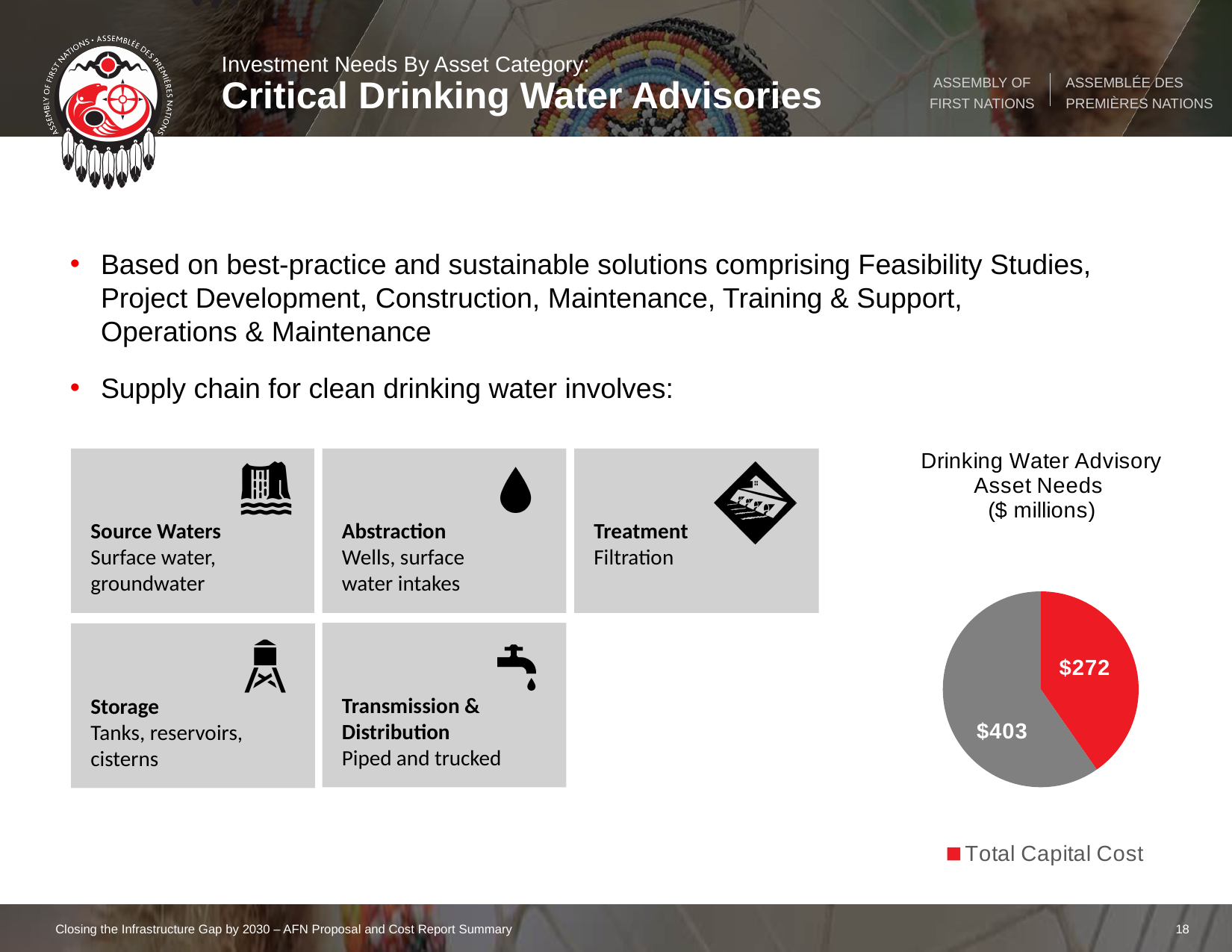
What is the title of the pie chart? Drinking Water Advisory Asset Needs ($ millions) What is the value of the Total Capital Cost slice in the pie chart? $272 Which slice of the pie chart is the smallest? Total Capital Cost ($272) Is the Total Capital Cost slice larger or smaller than the grey slice? smaller Which slice of the pie chart is the largest? the grey slice ($403) What colour is the Total Capital Cost slice in the pie chart? red What is the difference between the $403 slice and the $272 slice in the pie chart? $131 What is the value of the grey slice in the pie chart? $403 What kind of chart is shown on the slide? pie chart How many entries does the pie chart's legend list? 1 How many slices does the pie chart have? 2 What is the total of the two slices in the pie chart? $675